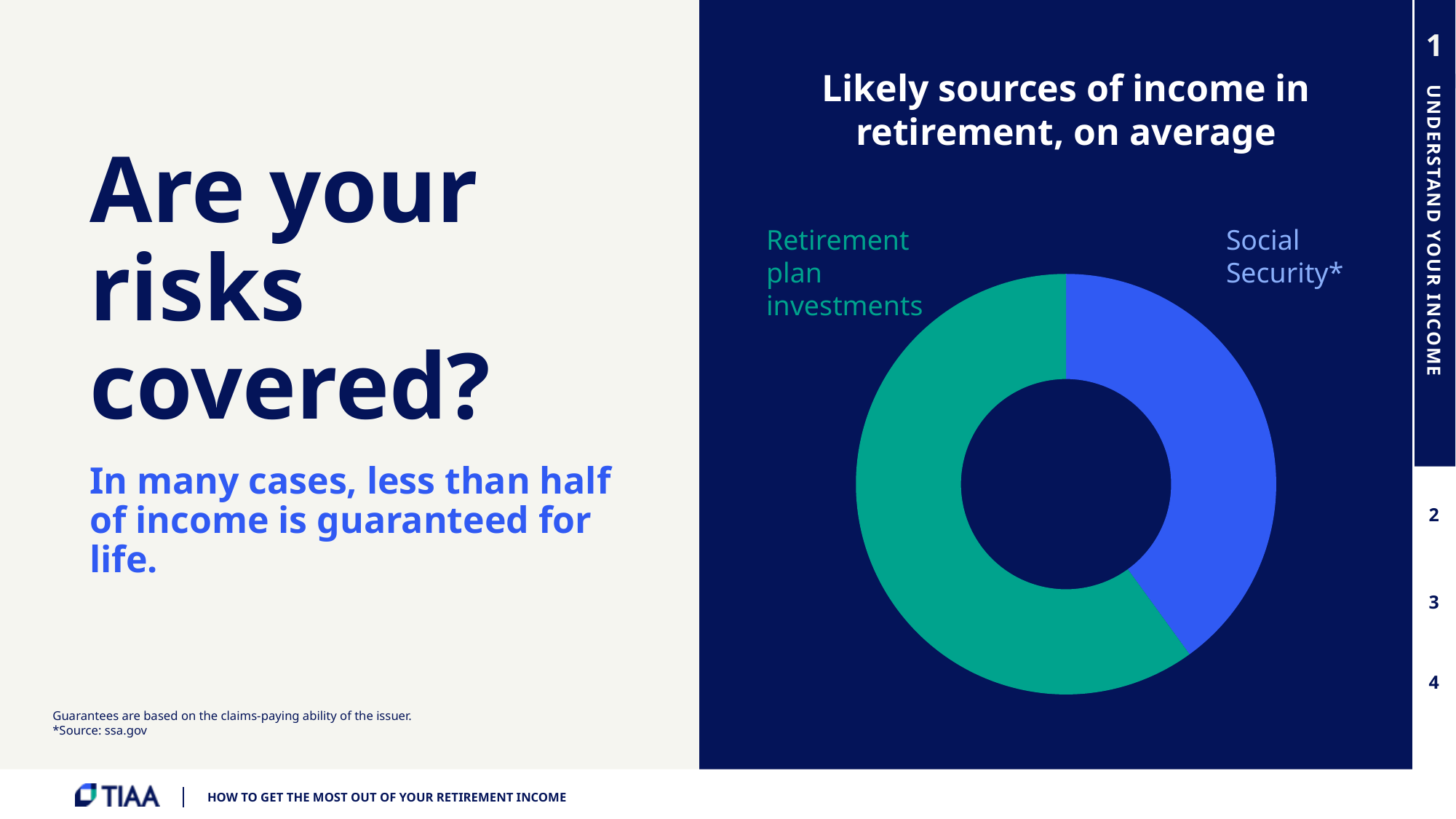
What is the title of the chart? Likely sources of income in retirement, on average Does the Social Security slice make up more or less than half of the chart? Less What kind of chart is shown on the slide? Pie chart (donut) How many categories does the chart show? 2 Which is larger: the share for Retirement plan investments or the share for Social Security? Retirement plan investments Does the Retirement plan investments slice make up more or less than half of the chart? More Which category has the largest share of the chart? Retirement plan investments Which category has the smallest share of the chart? Social Security What colour is the Social Security slice of the chart? Blue